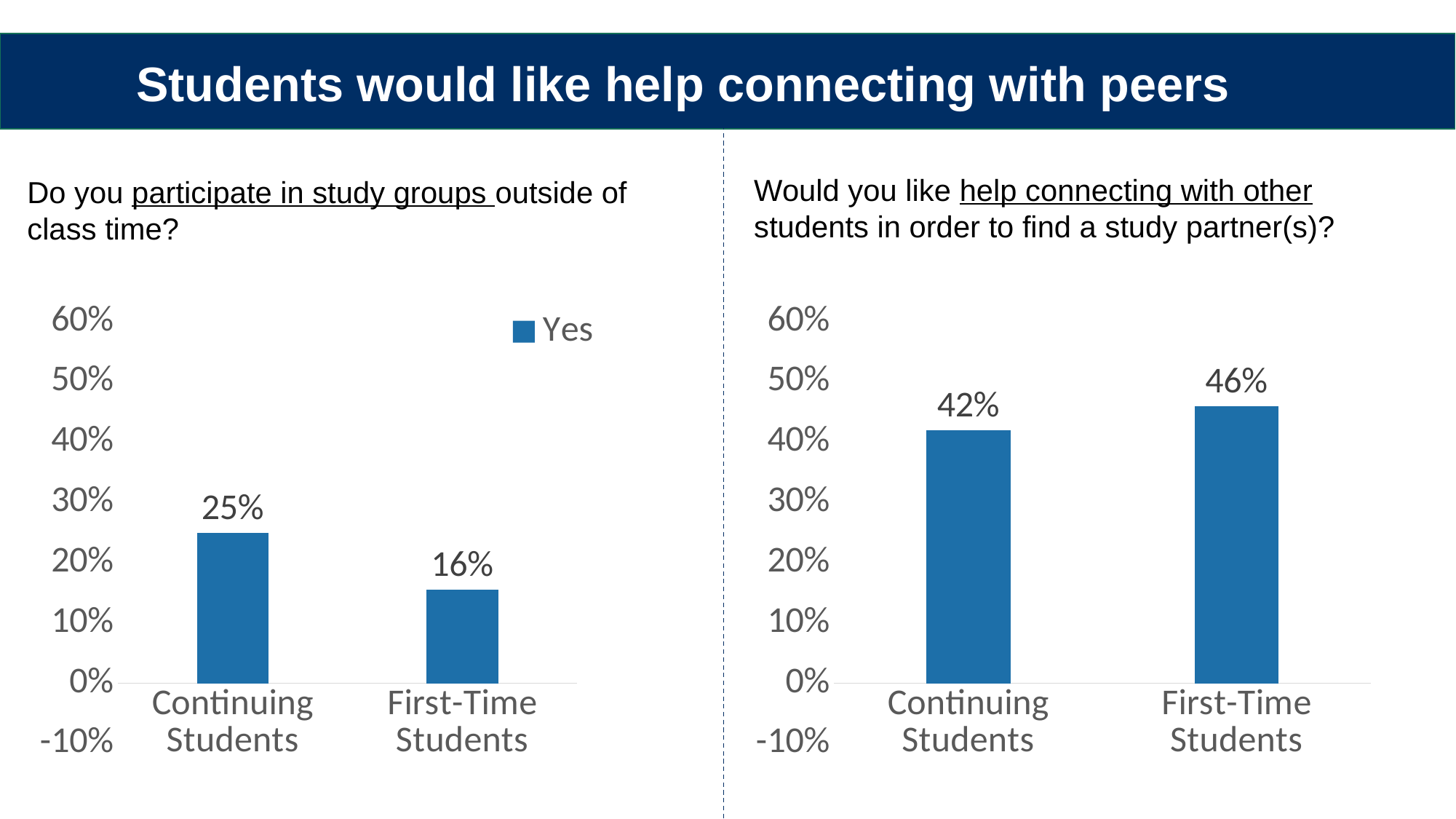
How many categories are shown in the left chart (study groups)? 2 In the left chart (study groups), what is the difference between Continuing Students and First-Time Students? 9% What kind of chart is the right chart (help connecting)? Bar chart In the left chart (study groups), what is the value for First-Time Students? 16% How many series does the legend of the left chart (study groups) list? 1 In the right chart (help connecting), what is the value for Continuing Students? 42% In the right chart (help connecting), what is the value for First-Time Students? 46% In the left chart (study groups), what is the value for Continuing Students? 25% In the left chart (study groups), which category has the highest value? Continuing Students In the right chart (help connecting), is the value for First-Time Students greater or less than 40%? greater In the right chart (help connecting), which category has the lowest value? Continuing Students In the right chart (help connecting), what is the difference between First-Time Students and Continuing Students? 4%